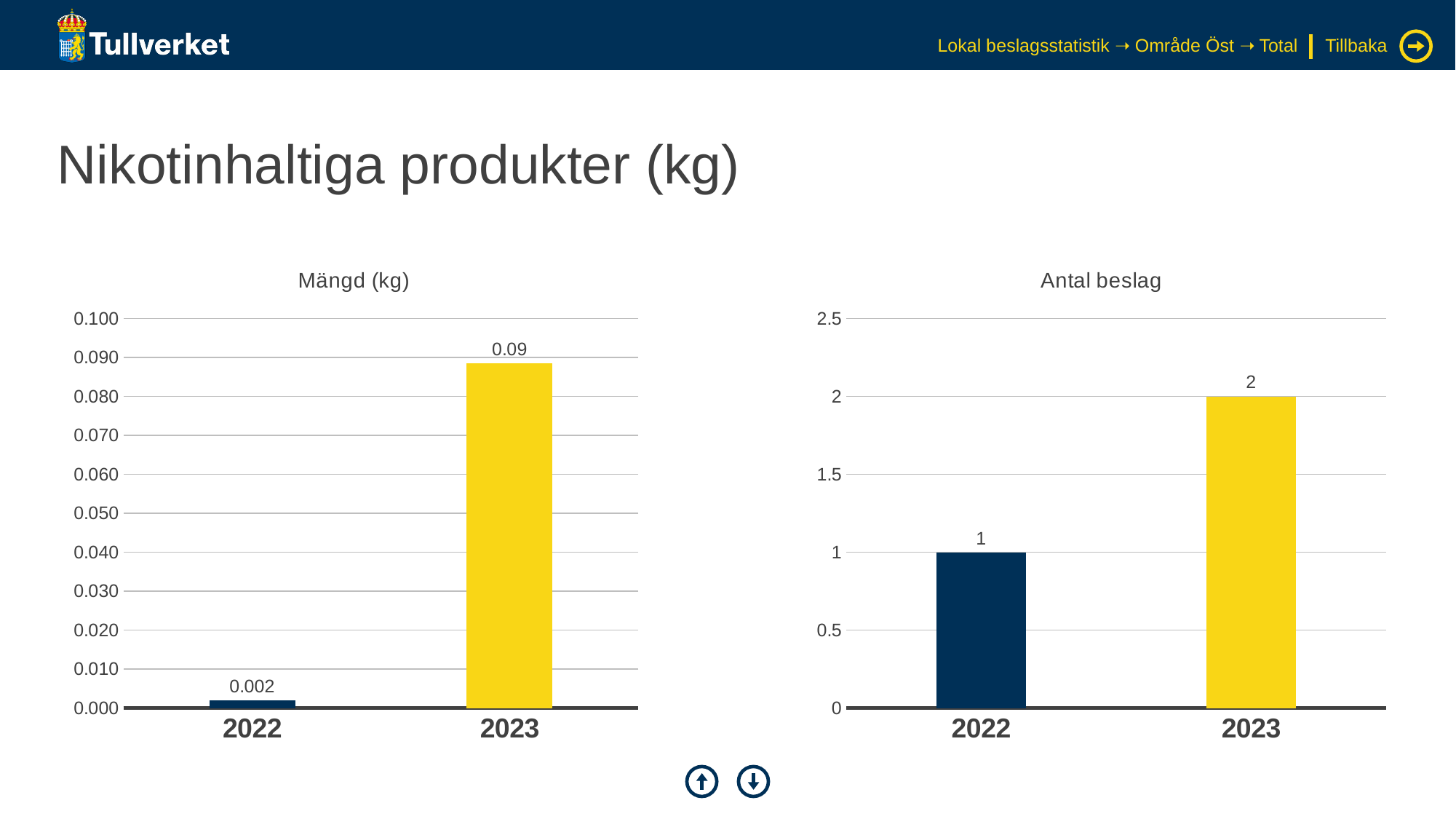
In the 'Mängd (kg)' chart, what is the value for 2023? 0.09 In the 'Antal beslag' chart, do the values rise or fall from 2022 to 2023? rise In the 'Mängd (kg)' chart, is the value for 2022 or 2023 larger? 2023 In the 'Mängd (kg)' chart, is the value for 2023 greater or less than 0.050? greater In the 'Mängd (kg)' chart, what is the value for 2022? 0.002 In the 'Antal beslag' chart, what is the difference between the values for 2023 and 2022? 1 How many categories are shown on the x axis of the 'Antal beslag' chart? 2 In the 'Antal beslag' chart, which year has the lowest value? 2022 What kind of chart is the 'Mängd (kg)' chart? bar chart In the 'Mängd (kg)' chart, which year has the highest value? 2023 In the 'Antal beslag' chart, what is the value for 2022? 1 In the 'Antal beslag' chart, what is the value for 2023? 2